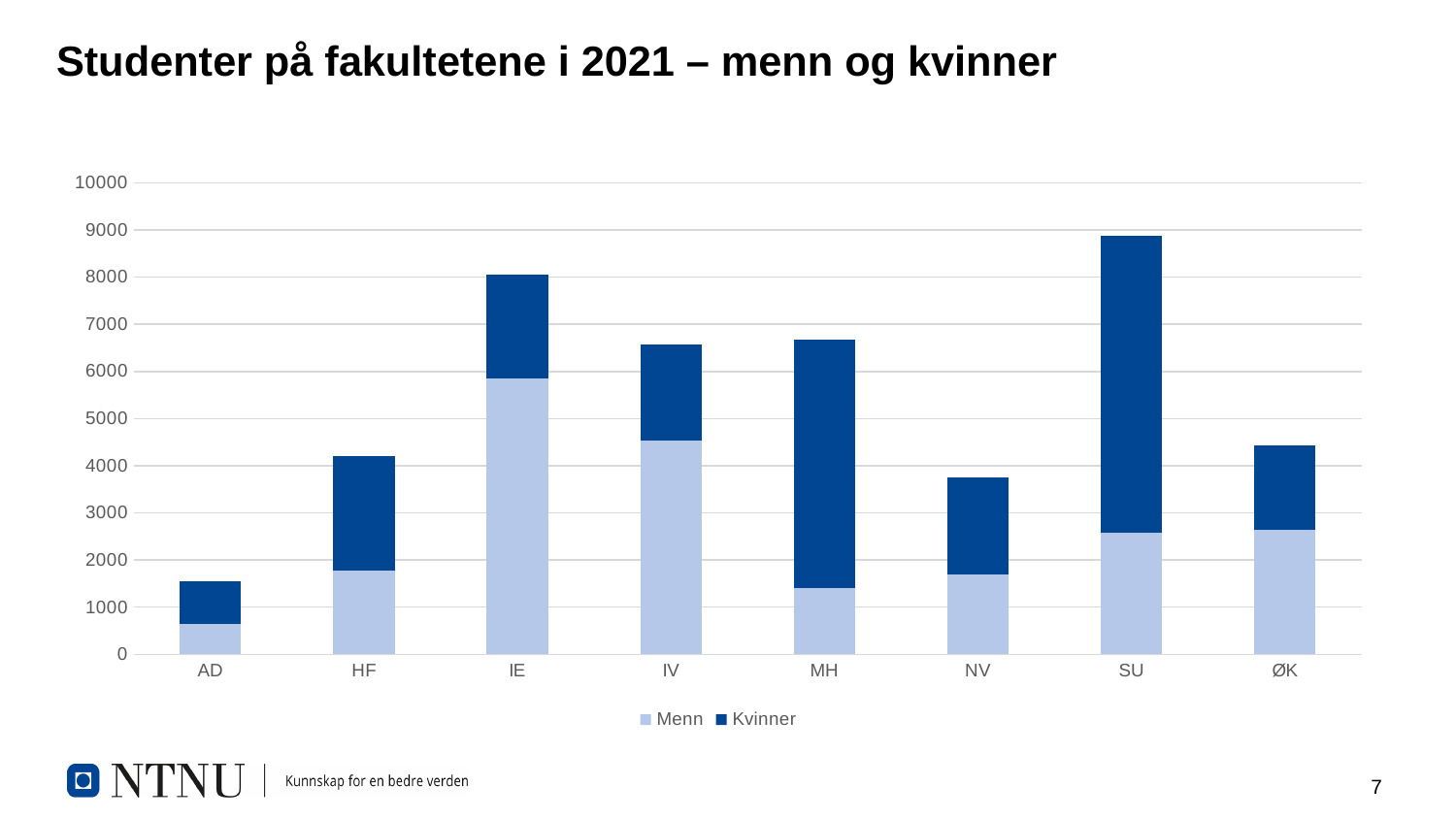
Which faculty has the larger total bar, HF or MH? MH Which faculty has the shortest stacked bar (fewest students in total)? AD How many series does the legend list? 2 Which faculty has the larger Menn segment, IE or SU? IE How many faculties (categories) are shown on the x axis? 8 Is the Menn segment for IE greater or less than 5000? greater What is the title of the chart on the slide? Studenter på fakultetene i 2021 – menn og kvinner Is the total bar height for NV greater or less than 4000? less What kind of chart is shown on the slide? Stacked bar chart Which faculty has the tallest stacked bar (most students in total)? SU Is the total bar height for AD greater or less than 2000? less